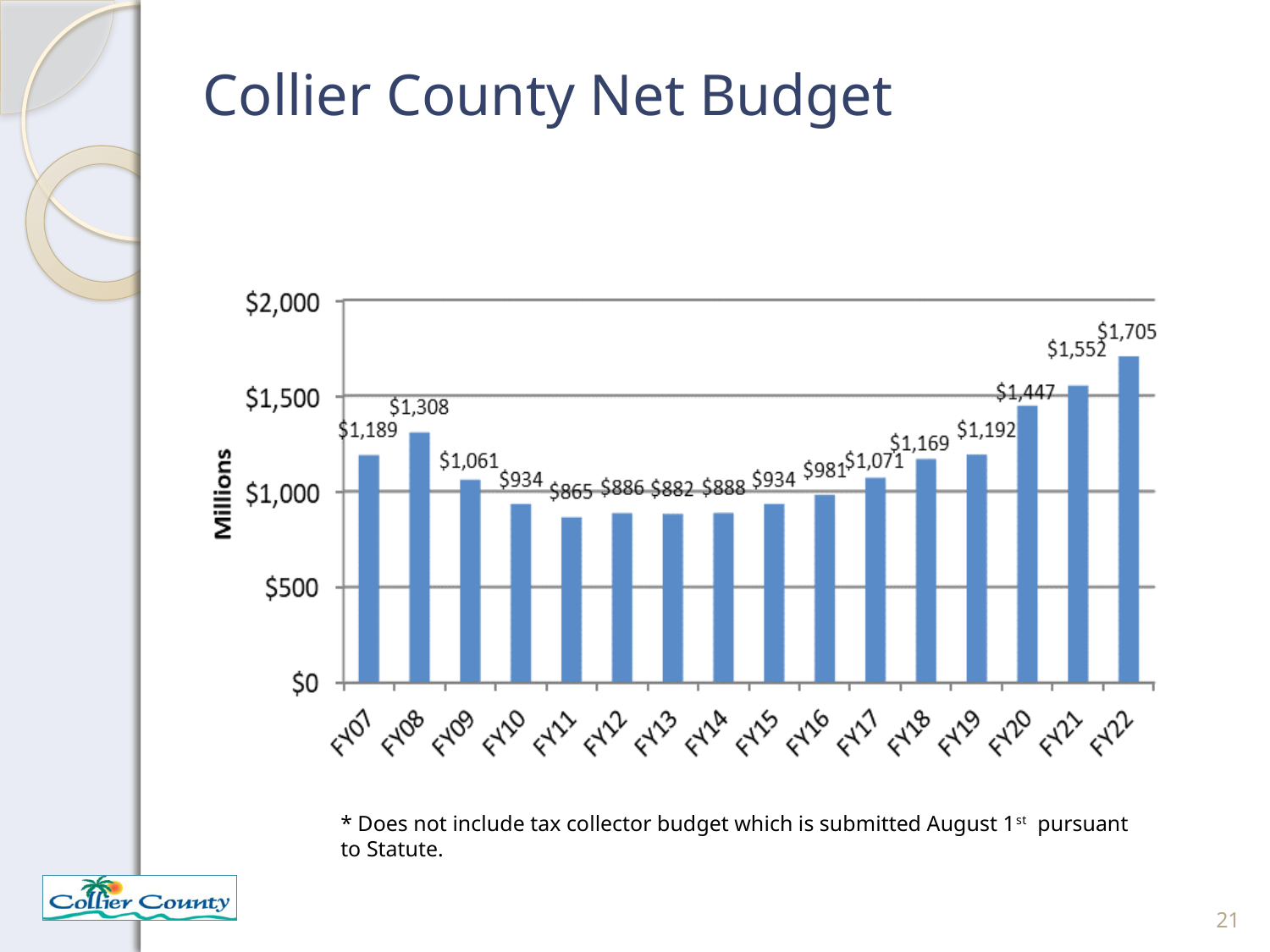
What is the net budget value shown for FY11? $865 What is the net budget value shown for FY22? $1,705 What is the net budget value shown for FY07? $1,189 Which fiscal year has the highest net budget? FY22 What is the difference between the FY08 and FY09 net budget values? $247 What kind of chart is used to show the Collier County Net Budget? Bar chart Which is larger, the net budget for FY08 or for FY19? FY08 How many fiscal years are shown on the x axis? 16 What is the difference between the FY22 and FY21 net budget values? $153 Which fiscal year has the lowest net budget? FY11 What is the label on the vertical axis of the chart? Millions Is the value for FY20 greater or less than $1,500? less